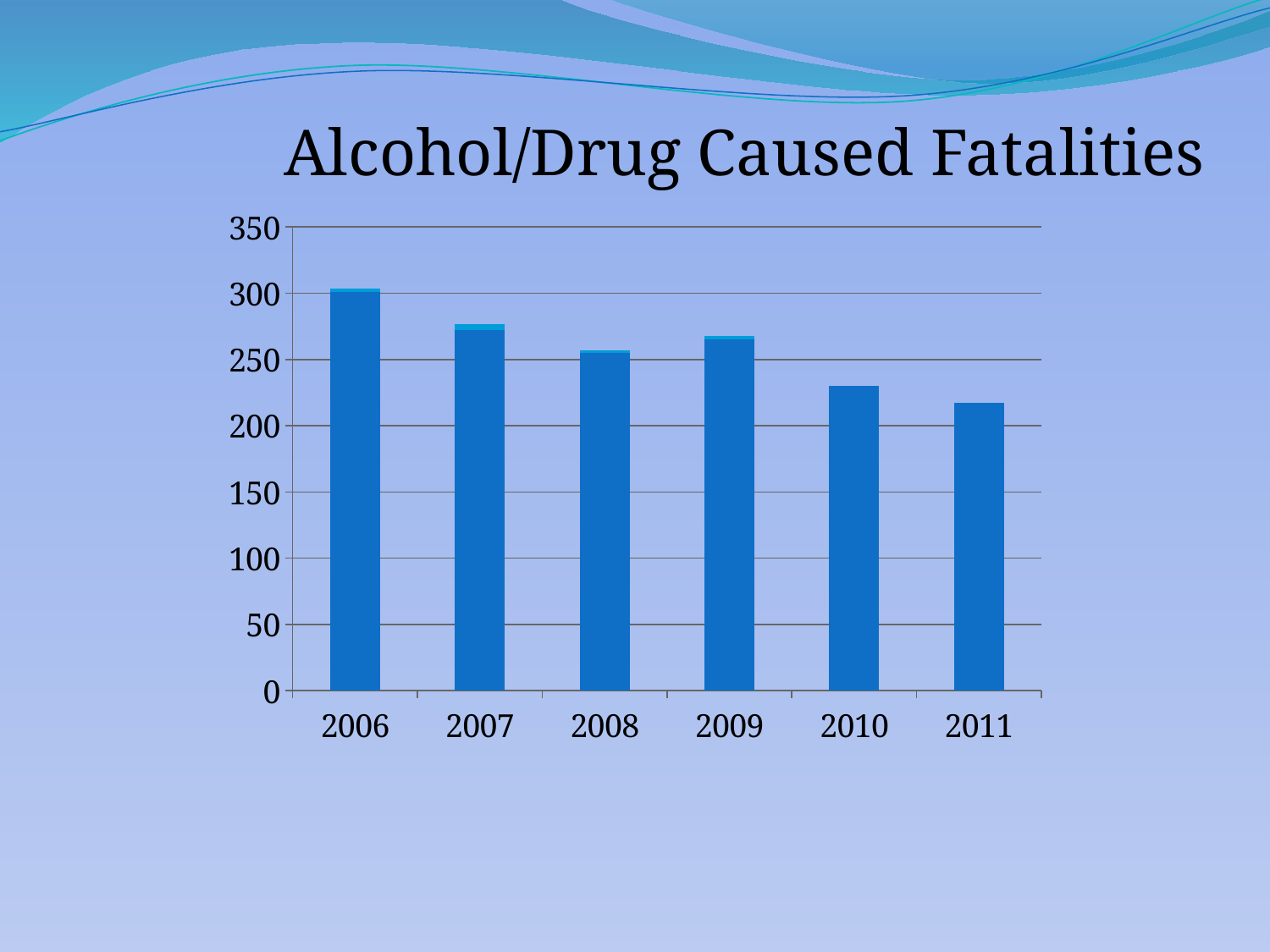
Is the value for 2007 greater or less than 300? less Is the value for 2011 greater or less than 250? less Which year has the lowest number of alcohol/drug caused fatalities? 2011 Overall, do the values rise or fall from 2006 to 2011? fall Is the value for 2006 greater or less than 250? greater Which year has the larger value, 2006 or 2011? 2006 What kind of chart is shown on the slide? bar chart Which year has the highest number of alcohol/drug caused fatalities? 2006 Which year has the larger value, 2007 or 2010? 2007 How many years are shown on the x axis of the chart? 6 What is the title of the chart? Alcohol/Drug Caused Fatalities